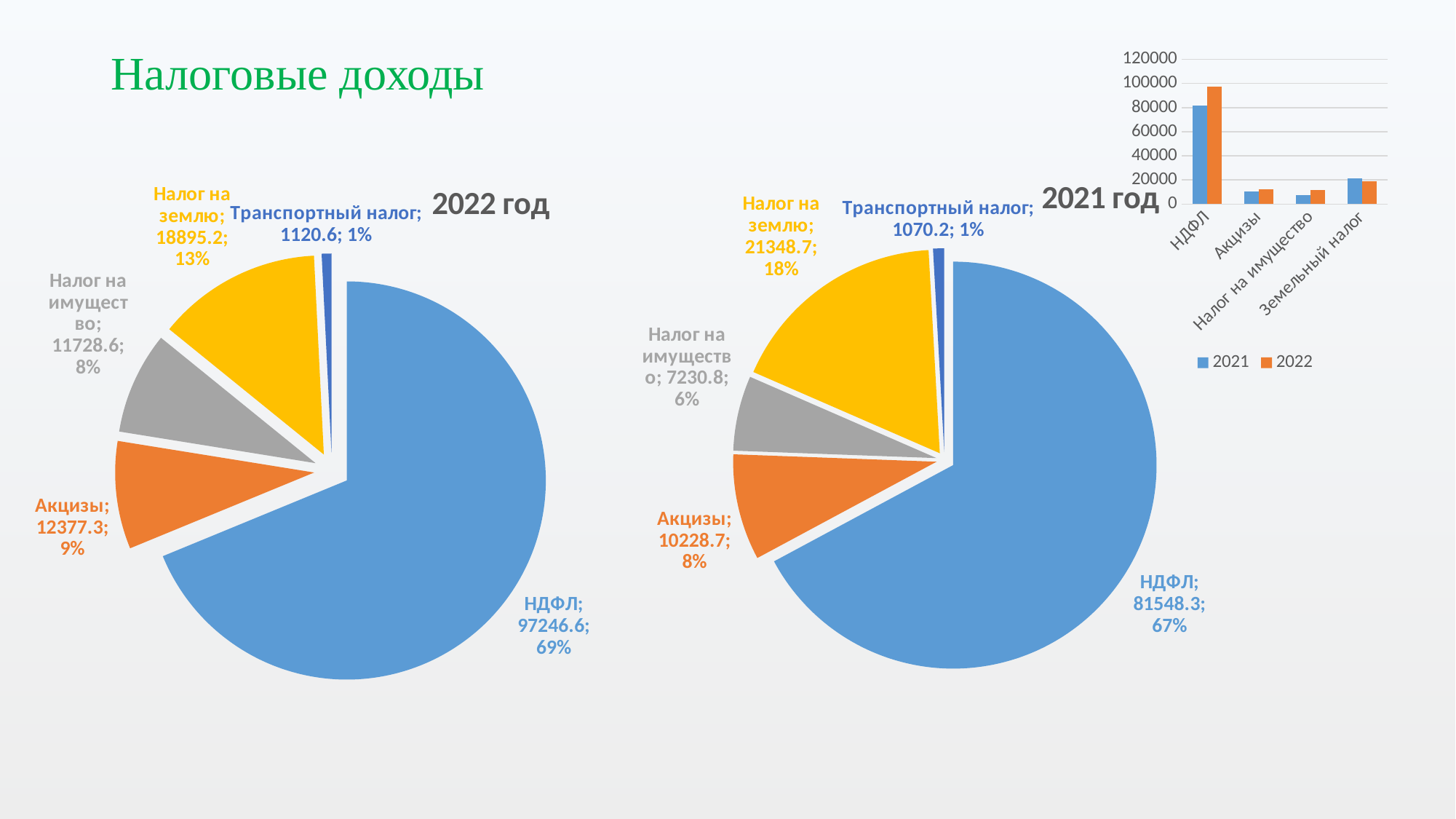
In the bar chart in the top right corner, is the 2022 value for НДФЛ greater or less than 80000? greater In the "2021 год" pie chart, what is the value for Акцизы? 10228.7 What kind of chart is the chart in the top right corner of the slide? bar chart How many categories does the "2022 год" pie chart show? 5 In the "2021 год" pie chart, what share of the pie does НДФЛ have? 67% In the "2022 год" pie chart, what is the value for НДФЛ? 97246.6 In the "2021 год" pie chart, which category has the largest value? НДФЛ How many series does the legend of the bar chart in the top right corner list? 2 In the "2022 год" pie chart, what share of the pie does Налог на землю have? 13% In the "2022 год" pie chart, which category has the smallest value? Транспортный налог In the "2021 год" pie chart, which is larger: Налог на имущество or Акцизы? Акцизы In the "2022 год" pie chart, what is the difference between the values for Налог на землю and Акцизы? 6517.9